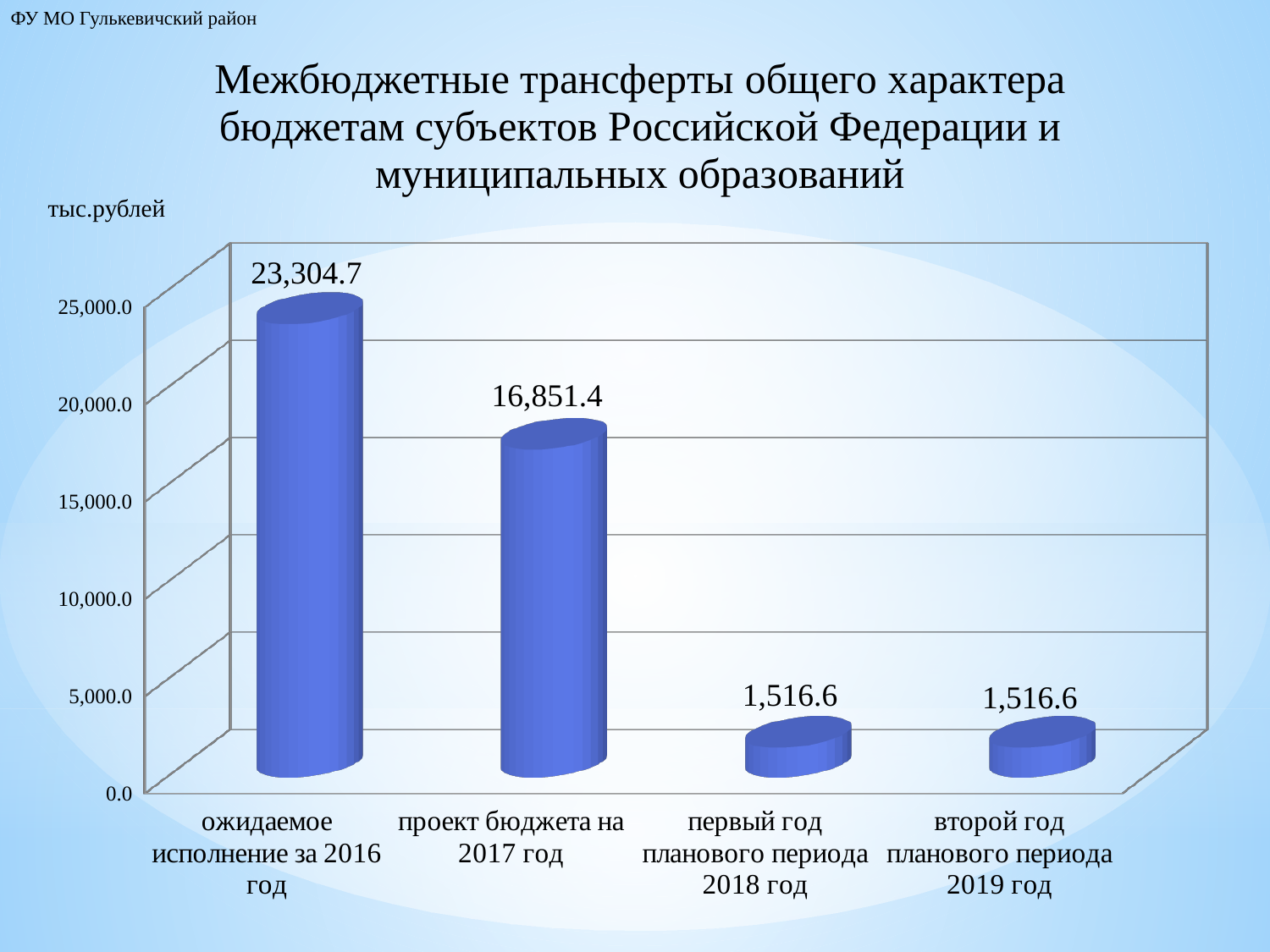
What is the value for 'проект бюджета на 2017 год'? 16,851.4 What is the value for 'второй год планового периода 2019 год'? 1,516.6 What kind of chart is shown on the slide? bar chart What is the value for 'первый год планового периода 2018 год'? 1,516.6 Is the value for 'проект бюджета на 2017 год' greater or less than 15,000.0? greater What is the value for 'ожидаемое исполнение за 2016 год'? 23,304.7 Which is larger: the value for 'проект бюджета на 2017 год' or the value for 'второй год планового периода 2019 год'? проект бюджета на 2017 год How many categories are shown on the x axis? 4 What is the difference between the value for 'проект бюджета на 2017 год' and the value for 'первый год планового периода 2018 год'? 15,334.8 Which category has the highest value? ожидаемое исполнение за 2016 год In what units are the values on the chart expressed, according to the label above the axis? тыс.рублей What is the difference between the value for 2016 (ожидаемое исполнение) and the value for 2017 (проект бюджета)? 6,453.3